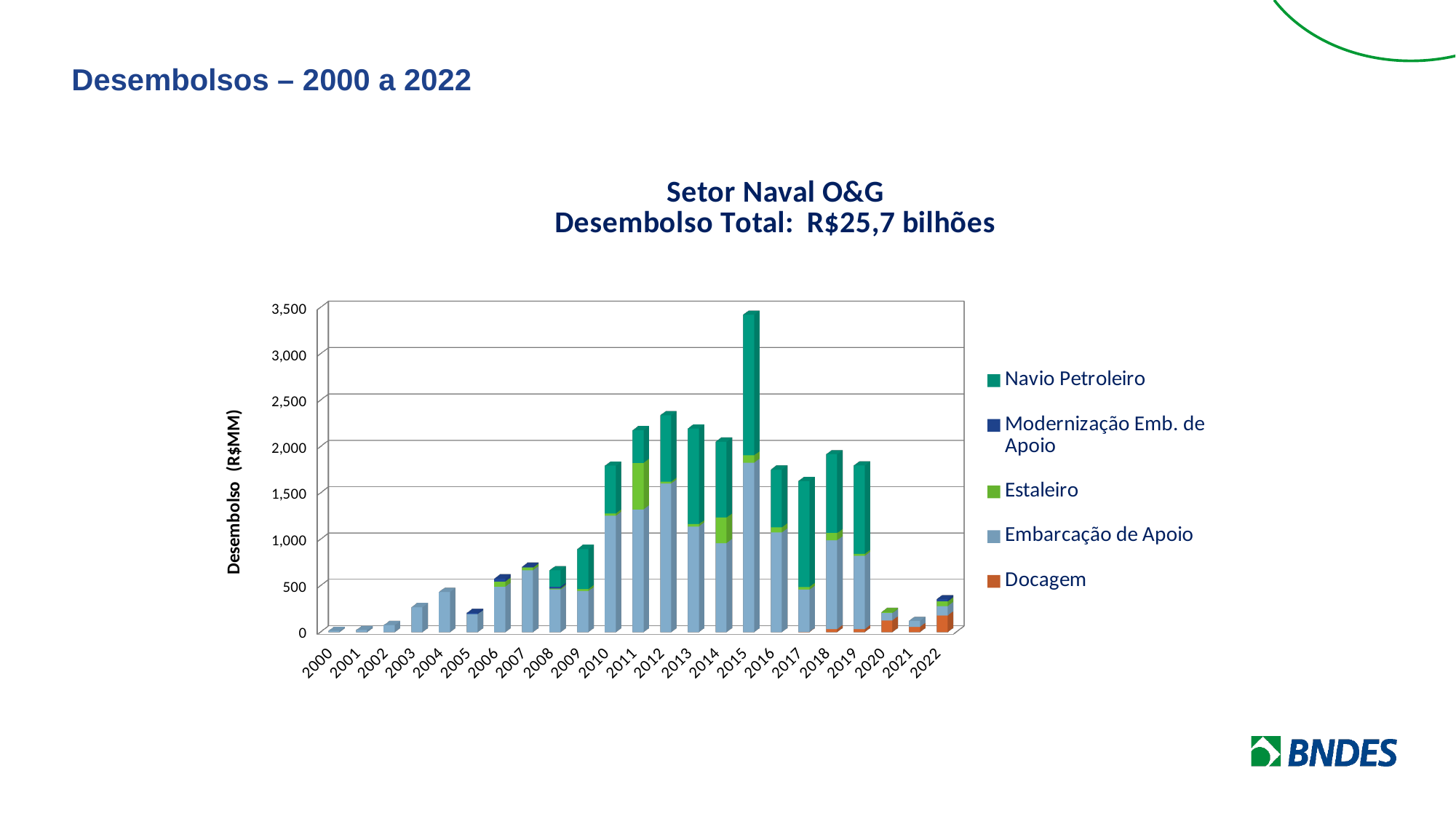
How many years (categories) are shown on the x axis of the chart? 23 Is the total value for 2012 greater or less than 2,000? greater What total disbursement is stated in the chart title? R$25,7 bilhões What kind of chart is shown on the slide? Stacked bar chart Which year has the highest total disbursement in the chart? 2015 Is the total value for 2015 greater or less than 3,000? greater What is the label of the chart's vertical axis? Desembolso (R$MM) Is the total value for 2004 greater or less than 500? less Do the total values rise or fall from 2015 to 2021? fall Which year has the larger total bar, 2012 or 2016? 2012 How many series does the chart's legend list? 5